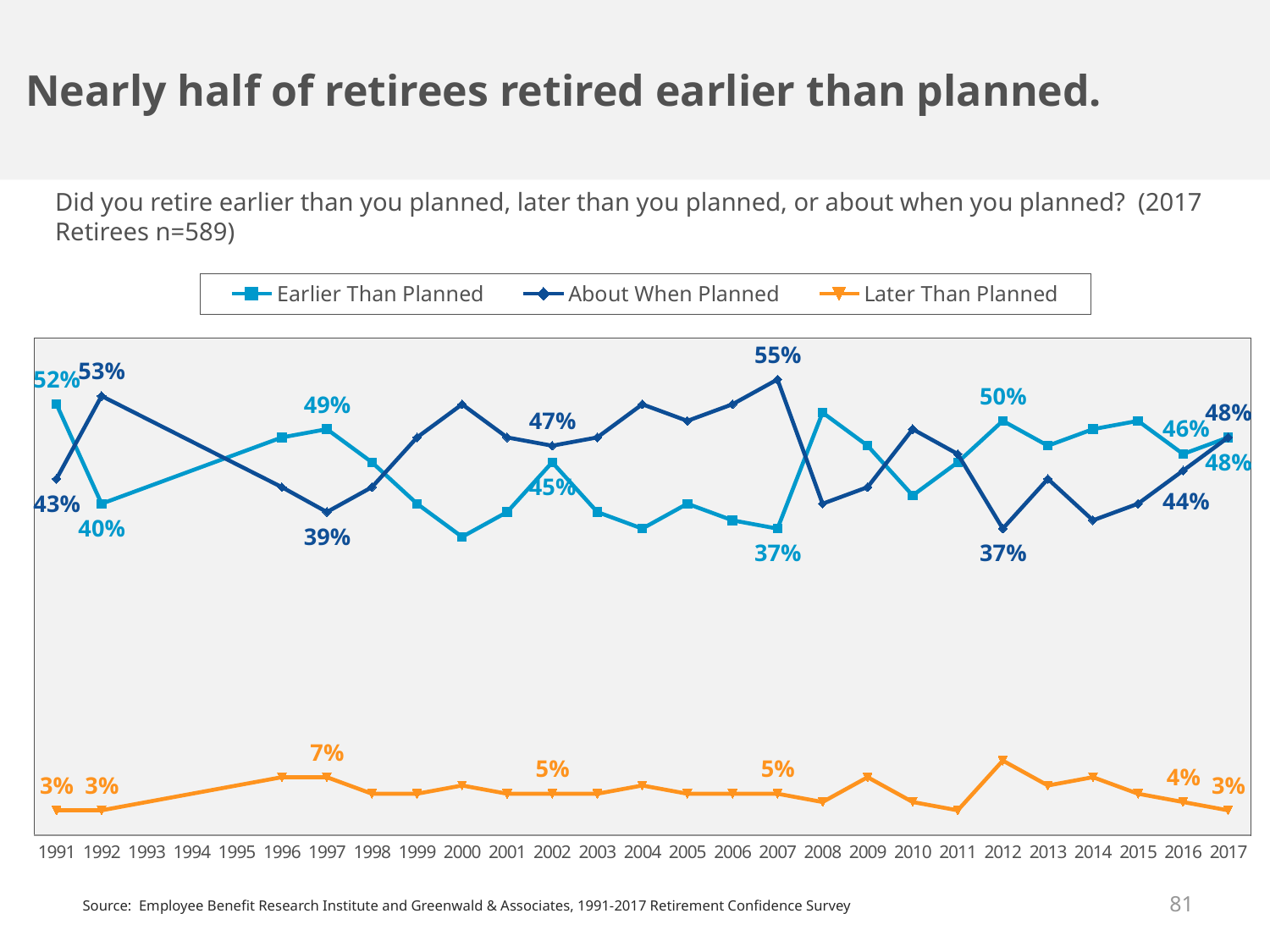
What is the value for Earlier Than Planned in 2012? 50% In 2007, what is the difference between About When Planned and Earlier Than Planned? 18 percentage points What is the value for About When Planned in 2012? 37% What are the three series named in the legend? Earlier Than Planned, About When Planned, Later Than Planned In 1992, which is larger: Earlier Than Planned or About When Planned? About When Planned What is the value for Later Than Planned in 2017? 3% What is the value for About When Planned in 2007? 55% What kind of chart is shown on the slide? Line chart What is the value for Earlier Than Planned in 1991? 52% How many years are shown on the x axis? 27 How many series does the legend list? 3 What is the value for Later Than Planned in 1997? 7%